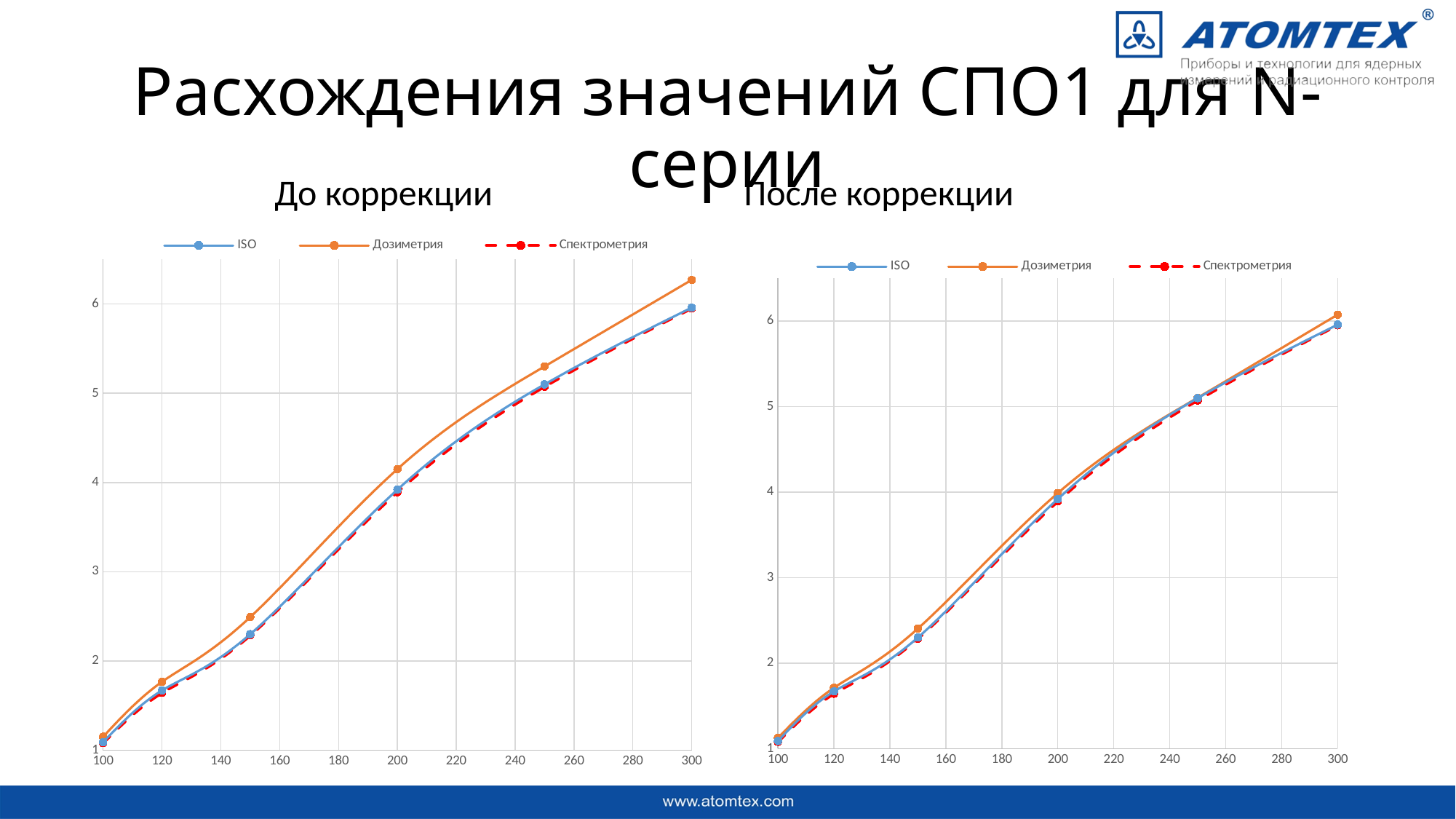
How many series does the legend of the 'После коррекции' chart list? 3 In the 'До коррекции' chart, which is larger at 300: the value for Дозиметрия or the value for ISO? Дозиметрия In the 'До коррекции' chart, which series has the highest value at 300? Дозиметрия In the 'После коррекции' chart, is the value for ISO at 120 greater or less than 2? less In the 'До коррекции' chart, is the value for Дозиметрия at 200 greater or less than 4? greater What kind of chart is the 'До коррекции' chart? line chart In the 'До коррекции' chart, do the values rise or fall as the x axis goes from 100 to 300? rise How many data points are plotted for each series in the 'До коррекции' chart? 6 What are the titles of the two charts on the slide? До коррекции and После коррекции In the 'До коррекции' chart, is the value for Дозиметрия at 150 greater or less than 2? greater Which series in the 'После коррекции' chart is drawn with a dashed line? Спектрометрия